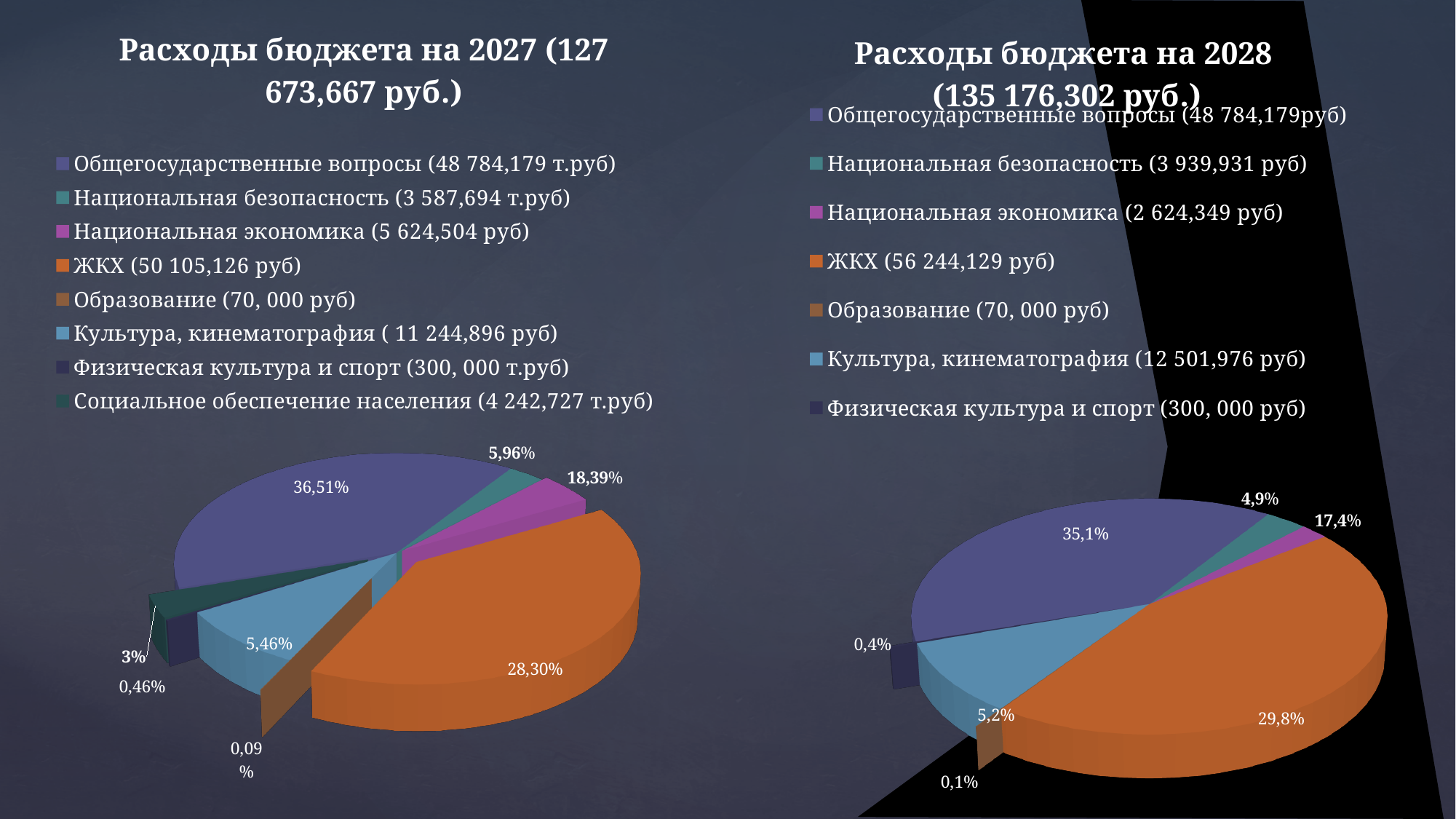
In the left chart (2027), what percentage is shown on the purple slice for Общегосударственные вопросы? 36,51% What kind of chart is used on the left chart titled "Расходы бюджета на 2027"? pie chart What kind of chart is used on the right chart titled "Расходы бюджета на 2028"? pie chart In the right chart (2028), what percentage is shown on the purple slice for Общегосударственные вопросы? 35,1% In the right chart (2028), what percentage is shown on the light blue slice for Культура, кинематография? 5,2% According to the legend of the right chart (2028), what amount is given for ЖКХ? 56 244,129 руб How many categories does the legend of the left chart (2027) list? 8 In the right chart (2028), which category has the largest slice? ЖКХ How many categories does the legend of the right chart (2028) list? 7